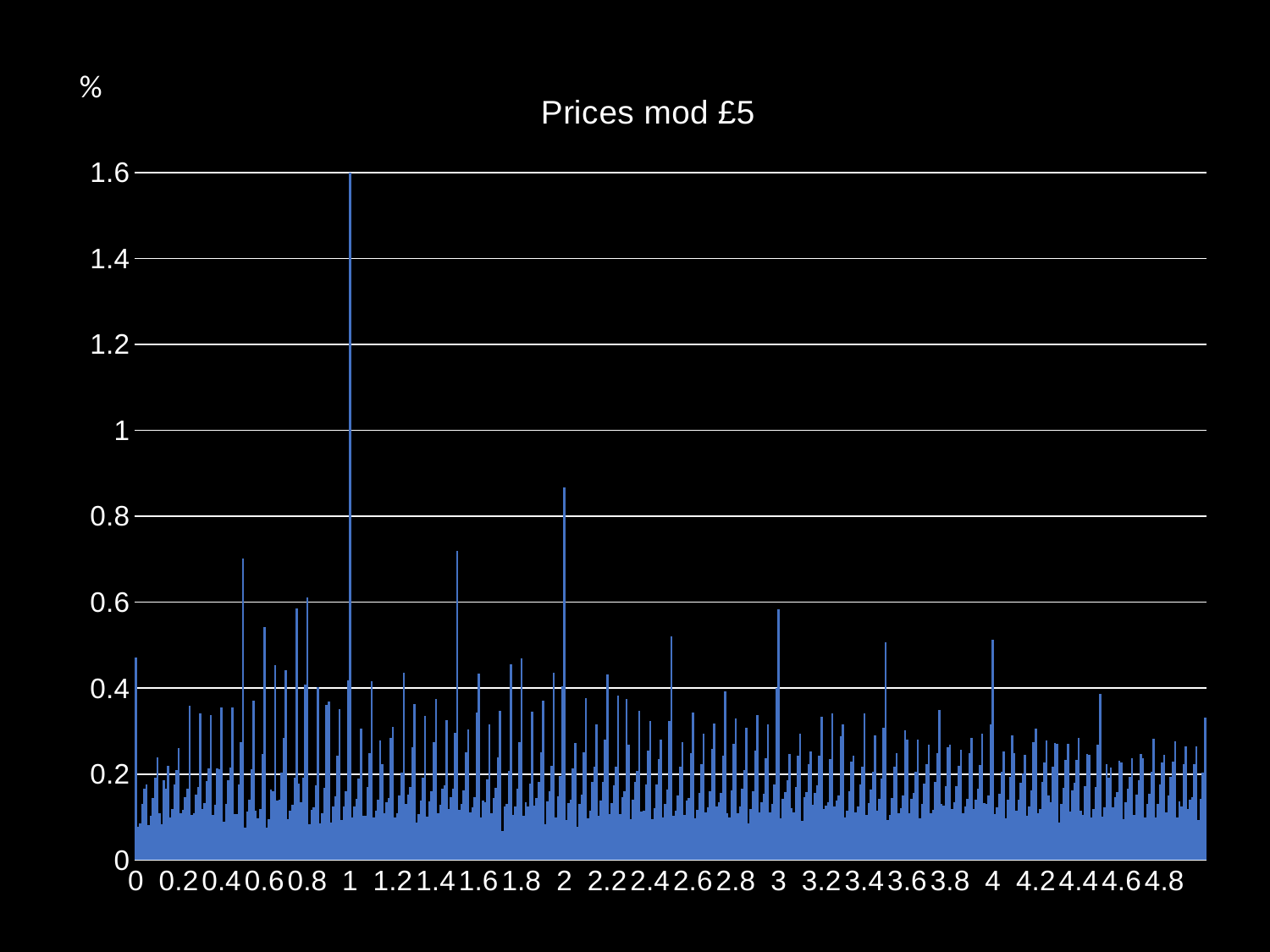
Which bar is taller, the one at x = 2 or the one at x = 3? x = 2 What is the title of the chart? Prices mod £5 How many labelled tick marks are there on the x axis? 25 At which x-axis value does the tallest bar occur? 1 What kind of chart is shown on the slide? bar chart Is the value of the bar at x = 4 greater or less than 0.4? greater Which bar is taller, the one at x = 1 or the one at x = 2? x = 1 Is the value of the bar at x = 3 greater or less than 0.4? greater Is the value of the bar at x = 2 greater or less than 0.8? greater What is the value of the tallest bar, at x = 1? 1.6 What unit is shown on the y axis? %